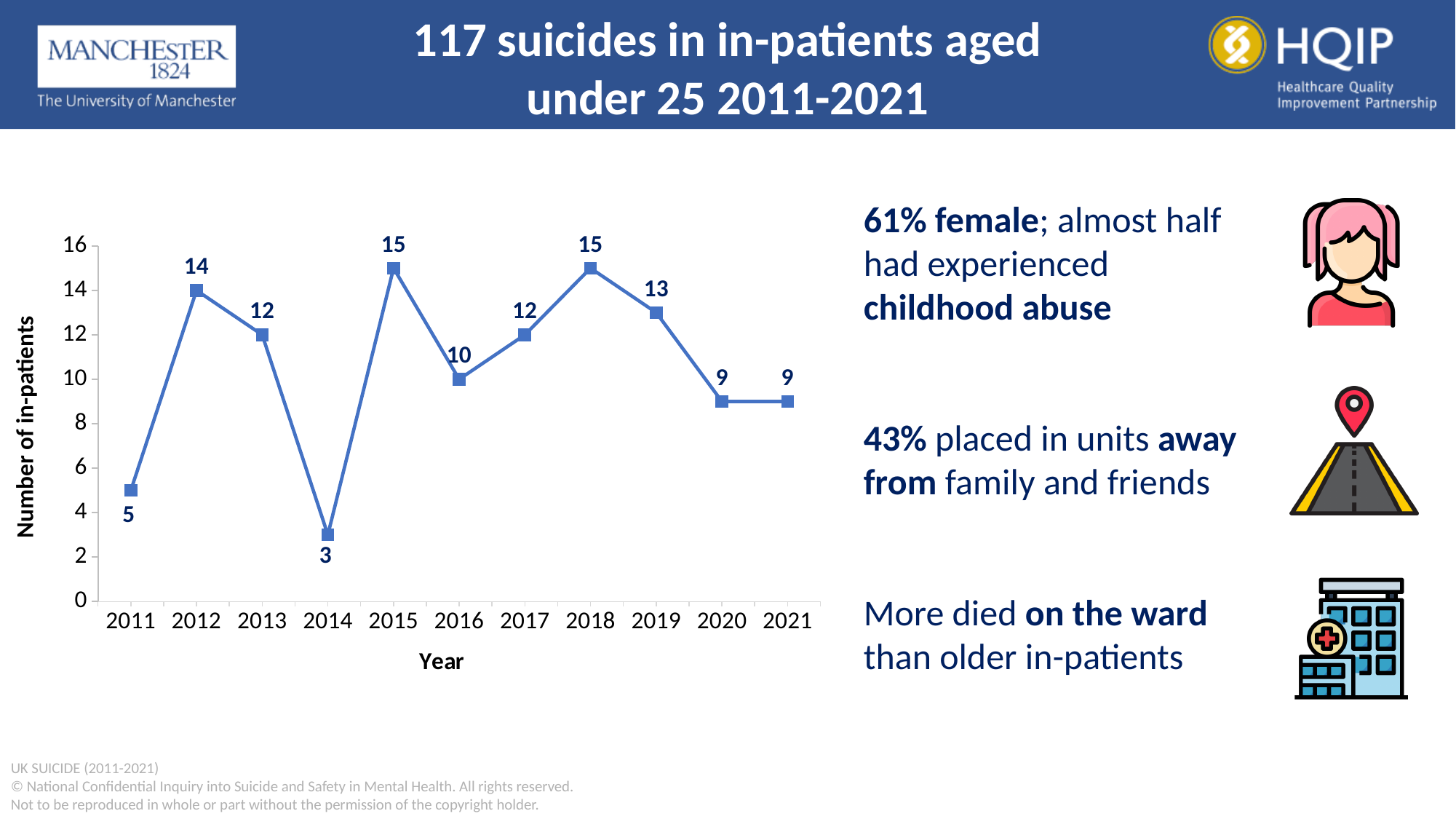
Which year has the larger value, 2013 or 2016? 2013 What is the label of the y axis? Number of in-patients How many years are plotted on the x axis? 11 What is the difference between the values for 2012 and 2011? 9 Do the values rise or fall from 2018 to 2020? Fall What is the number of in-patients for 2019? 13 What is the difference between the values for 2015 and 2014? 12 Which year has the lowest number of in-patients? 2014 What kind of chart is shown on the slide? Line chart What is the number of in-patients for 2014? 3 What is the highest value plotted on the chart? 15 What is the number of in-patients for 2011? 5